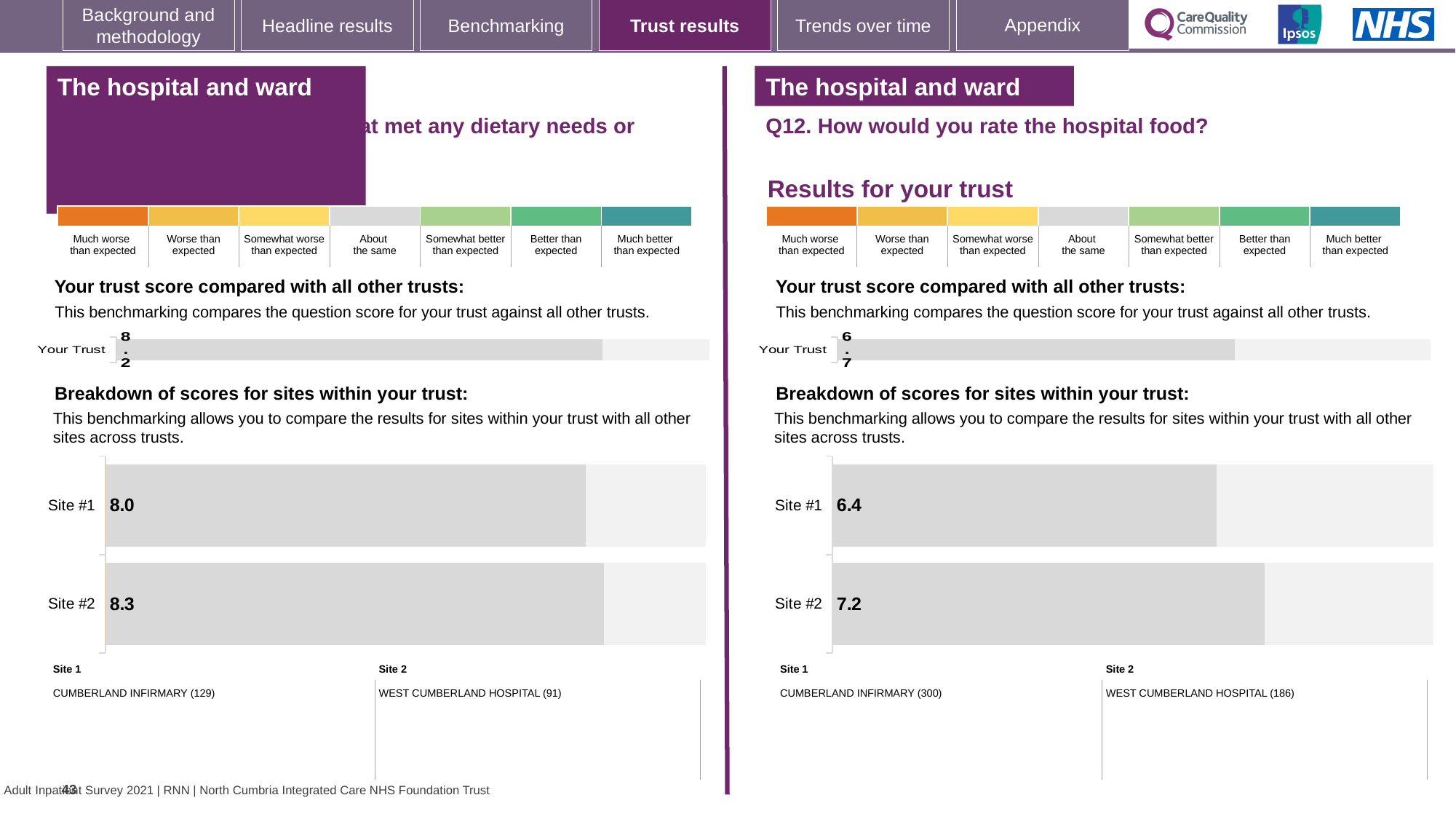
On the right-hand chart (Q12. How would you rate the hospital food?), what is the 'Your Trust' score? 6.7 On the left-hand site breakdown chart, what is the score for Site #2? 8.3 On the left-hand site breakdown chart, what is the difference between the Site #2 and Site #1 scores? 0.3 What type of chart is used for the site breakdown on the right-hand side (Q12)? Bar chart On the left-hand site breakdown chart, which site has the lower score? Site #1 On the right-hand chart (Q12. How would you rate the hospital food?), what is the score for Site #2? 7.2 How many sites are shown in the site breakdown chart on the right-hand side (Q12)? 2 On the left-hand chart, what is the 'Your Trust' score? 8.2 On the right-hand chart (Q12. How would you rate the hospital food?), what is the score for Site #1? 6.4 On the right-hand chart (Q12. How would you rate the hospital food?), what is the difference between the Site #2 and Site #1 scores? 0.8 On the right-hand chart (Q12. How would you rate the hospital food?), which site has the higher score? Site #2 On the left-hand site breakdown chart, what is the score for Site #1? 8.0